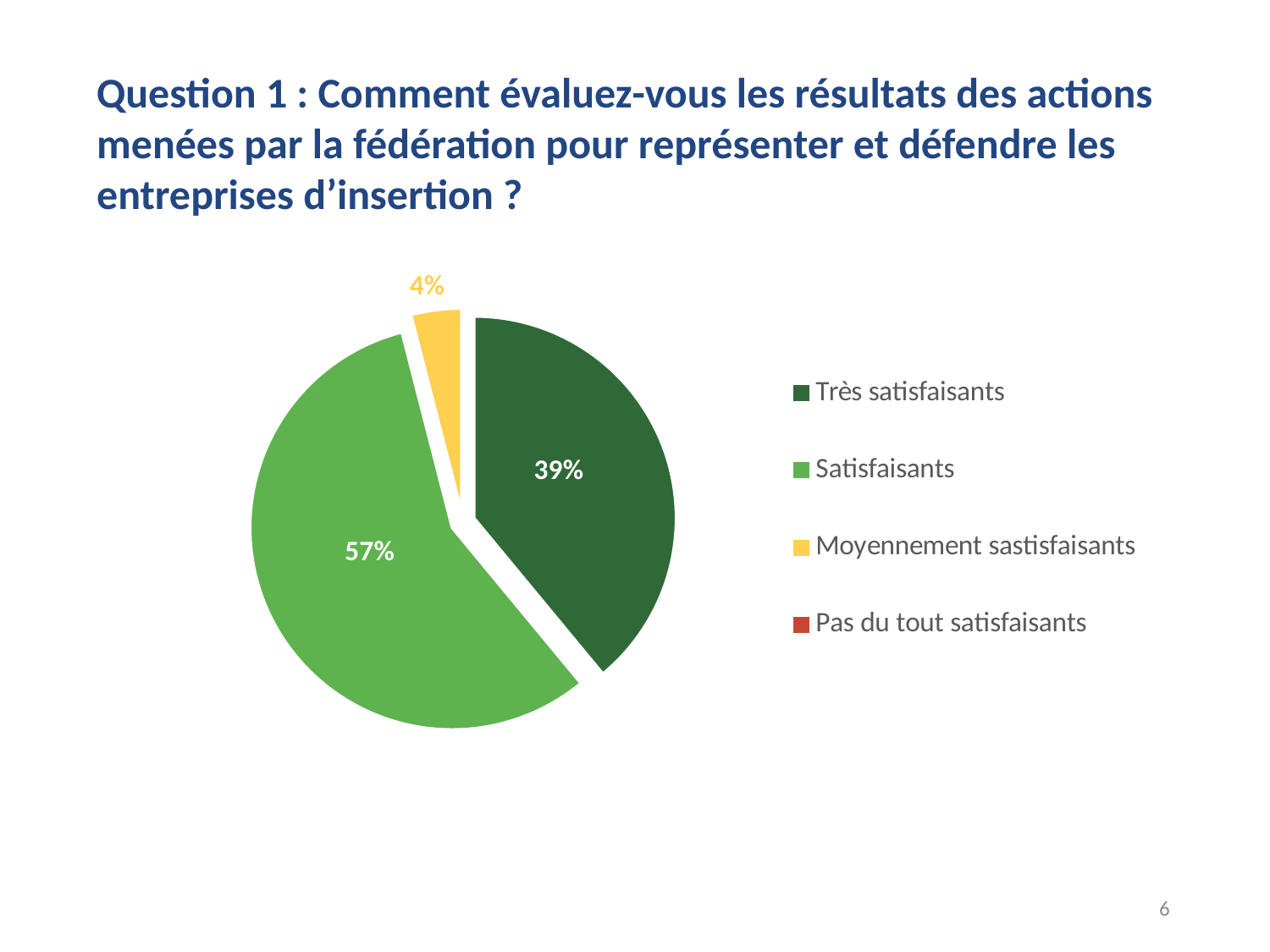
What share of the pie is labelled "Moyennement sastisfaisants"? 4% Which category with a visible slice has the smallest share of the pie? Moyennement sastisfaisants What share of the pie is labelled "Satisfaisants"? 57% How many slices with a percentage label are visible in the pie? 3 Which is larger, the "Très satisfaisants" slice or the "Moyennement sastisfaisants" slice? Très satisfaisants What share of the pie is labelled "Très satisfaisants"? 39% What colour is the "Satisfaisants" slice? light green What is the difference in percentage points between the "Satisfaisants" and "Très satisfaisants" slices? 18 How many entries does the legend list? 4 What kind of chart is shown on the slide? pie chart Which legend entry is shown in red? Pas du tout satisfaisants Which category has the largest slice of the pie? Satisfaisants